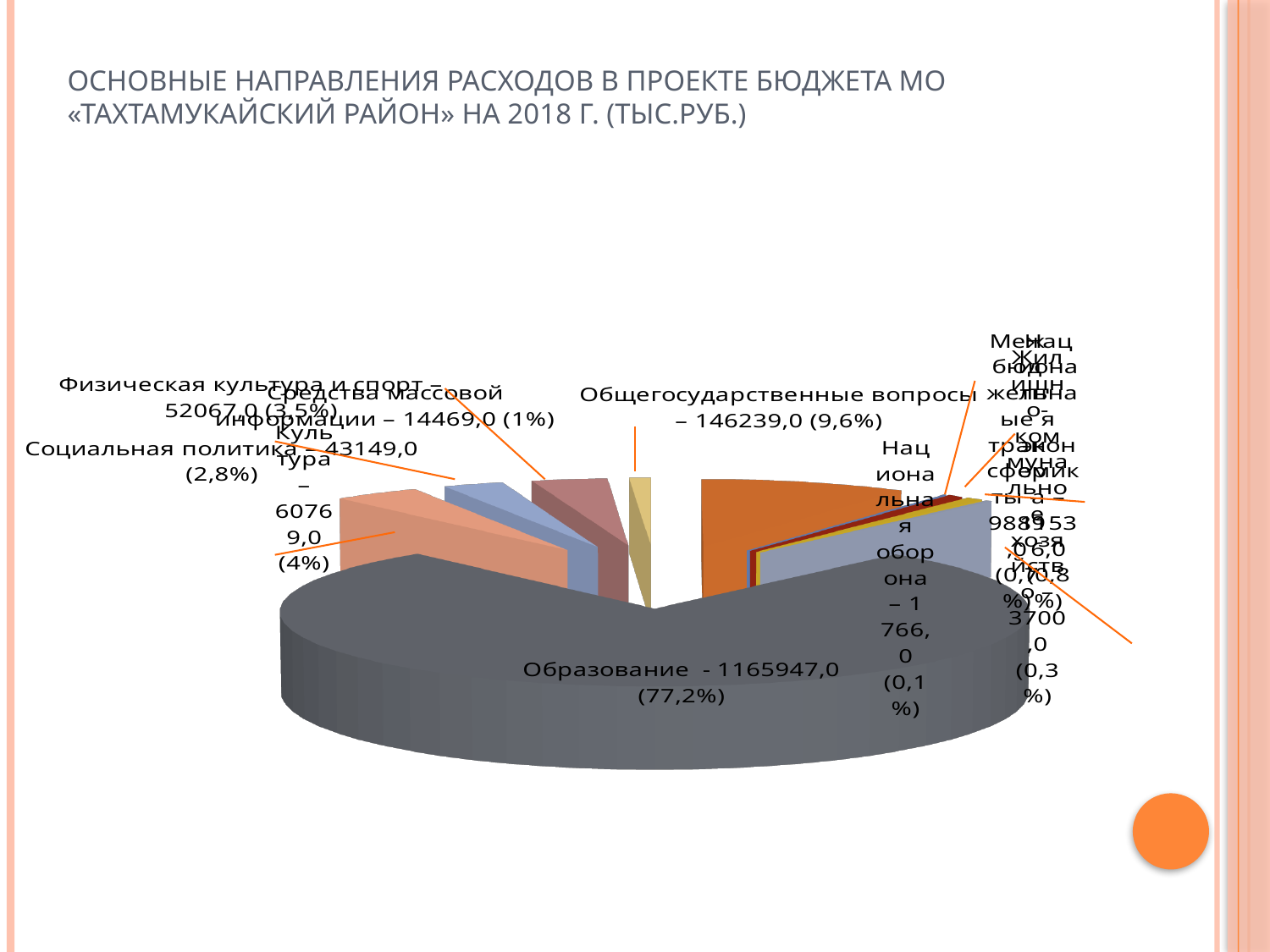
What is the value shown for Общегосударственные вопросы? 146239,0 What is the value shown for Образование? 1165947,0 What type of chart is shown on the slide? pie chart What share of the pie does Общегосударственные вопросы account for? 9,6% What is the value shown for Средства массовой информации? 14469,0 What share of the pie does Культура account for? 4% What is the value shown for Физическая культура и спорт? 52067,0 What is the value shown for Социальная политика? 43149,0 Which category has the largest slice of the pie? Образование What is the difference between the values for Физическая культура и спорт and Социальная политика? 8918,0 What share of the pie does Образование account for? 77,2% Which is larger, Физическая культура и спорт or Социальная политика? Физическая культура и спорт